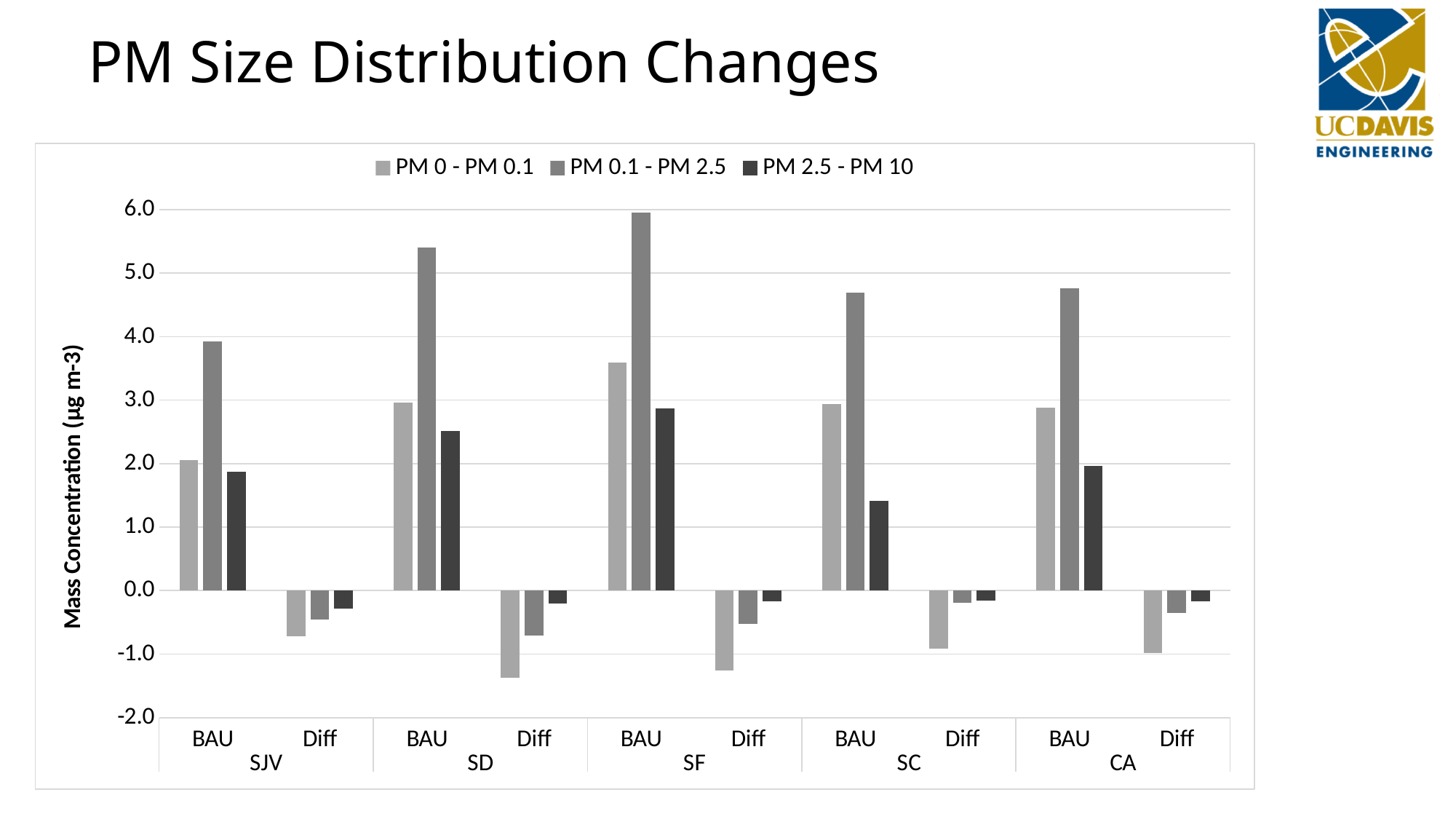
How many series does the legend list? 3 What is the label of the y axis? Mass Concentration (µg m-3) Is the BAU value for PM 2.5 - PM 10 in SC greater or less than 2.0? less What kind of chart is shown on the slide? bar chart Which region has the tallest PM 0.1 - PM 2.5 bar under BAU? SF Within the SJV BAU group, which series has the tallest bar? PM 0.1 - PM 2.5 Is the BAU value for PM 0 - PM 0.1 in SF greater or less than 3.0? greater Is the Diff value for PM 0 - PM 0.1 in SD greater or less than -1.0? less How many regions are shown along the x axis? 5 Which region has the most negative PM 0 - PM 0.1 bar under Diff? SD Which is larger, the BAU PM 0 - PM 0.1 bar for SF or for SD? SF